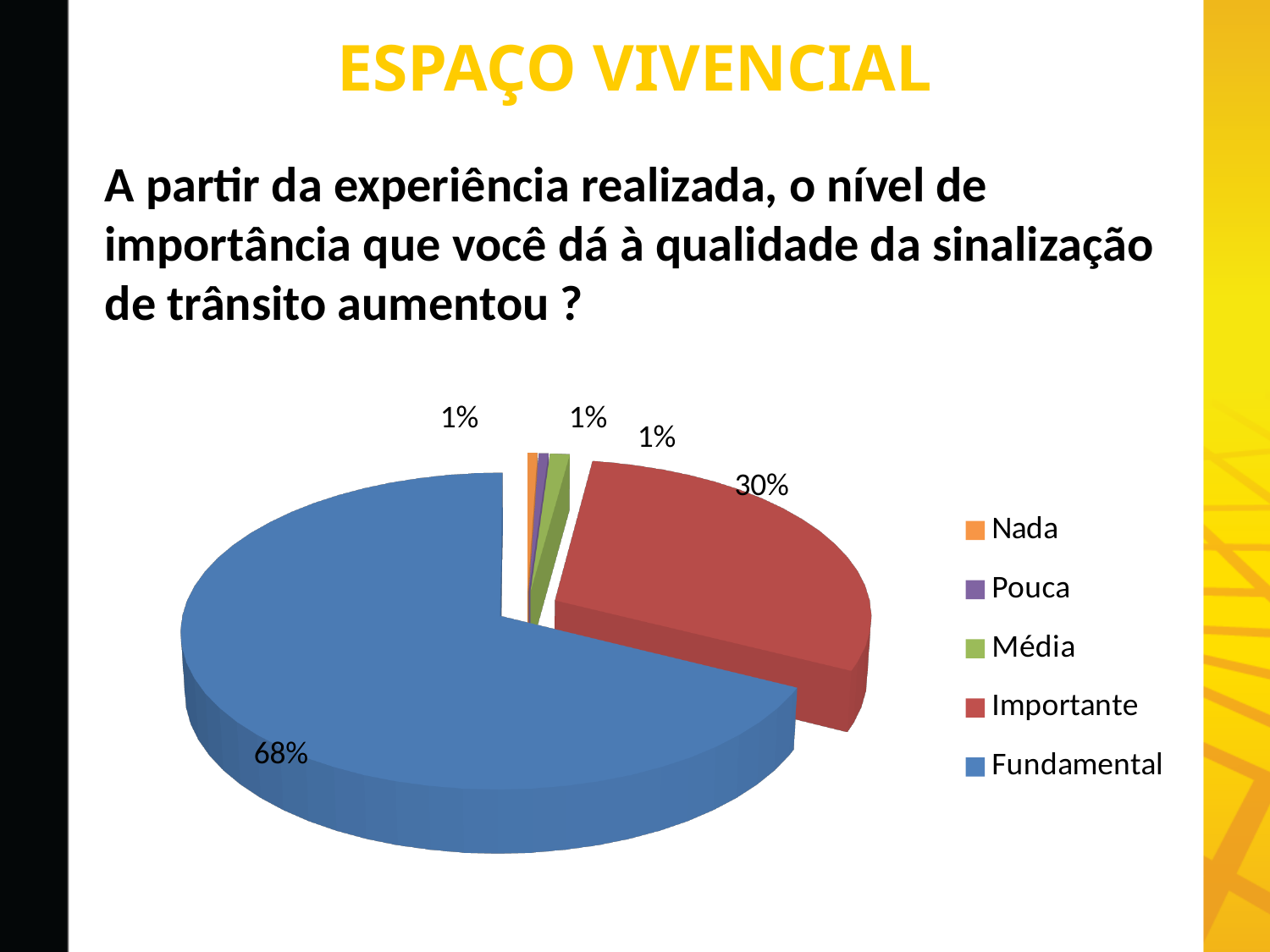
What is the difference in percentage points between the Fundamental slice and the Importante slice? 38 Which legend entry is shown in red? Importante Which slice is larger, Importante or Fundamental? Fundamental What percentage of the pie chart is labelled for Fundamental? 68% What is the combined percentage of the Nada, Pouca and Média slices? 3% Which category has the largest slice of the pie chart? Fundamental What kind of chart is shown on the slide? Pie chart What percentage of the pie chart is labelled for Importante? 30% What percentage of the pie chart is labelled for Média? 1% What share of the pie does the Importante slice represent? 30% What colour is the Fundamental slice in the pie chart? Blue How many categories does the pie chart show? 5